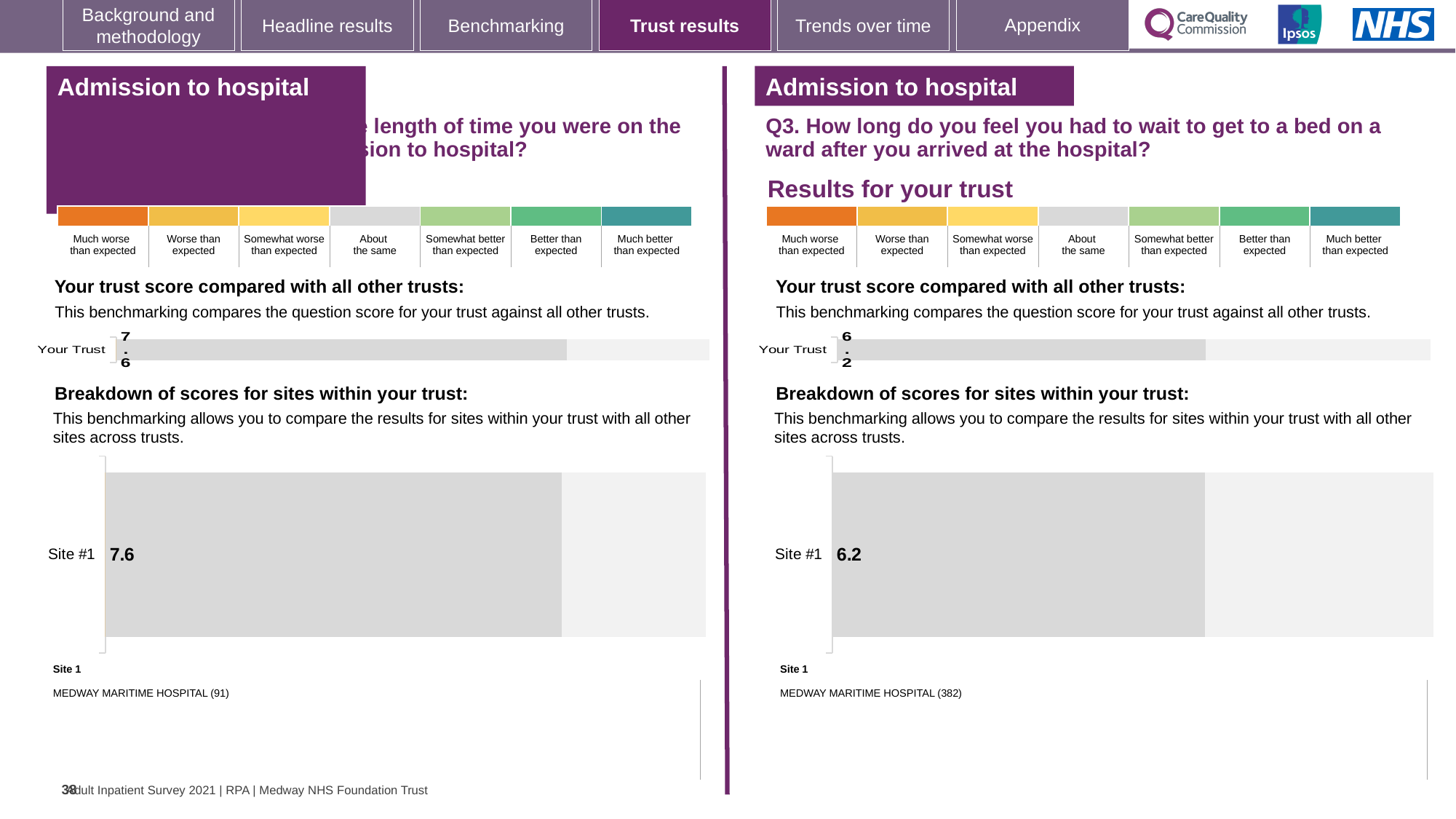
What is the difference between the Site #1 score in the left-hand panel and the Site #1 score in the right-hand panel (Q3)? 1.4 In the right-hand panel (Q3), what number is shown in brackets after MEDWAY MARITIME HOSPITAL below the site breakdown chart? 382 In the left-hand panel, what score is shown for Site #1 in the breakdown of scores for sites chart? 7.6 In the left-hand panel, what is the 'Your Trust' score shown in the trust benchmarking bar chart? 7.6 Which panel shows the higher Site #1 score, the left-hand panel or the right-hand panel (Q3)? The left-hand panel In the right-hand panel (Q3), what is the 'Your Trust' score shown in the trust benchmarking bar chart? 6.2 What kind of chart is used for the breakdown of scores for sites in the right-hand panel (Q3)? Bar chart In the right-hand panel (Q3), what score is shown for Site #1 in the breakdown of scores for sites chart? 6.2 In the right-hand panel (Q3), which hospital is listed as Site 1 below the site breakdown chart? MEDWAY MARITIME HOSPITAL Which panel shows the higher 'Your Trust' score, the left-hand panel or the right-hand panel (Q3)? The left-hand panel How many sites are shown in the breakdown of scores for sites chart in the left-hand panel? 1 How many bars are plotted in the 'Your Trust' benchmarking chart in the right-hand panel (Q3)? 1